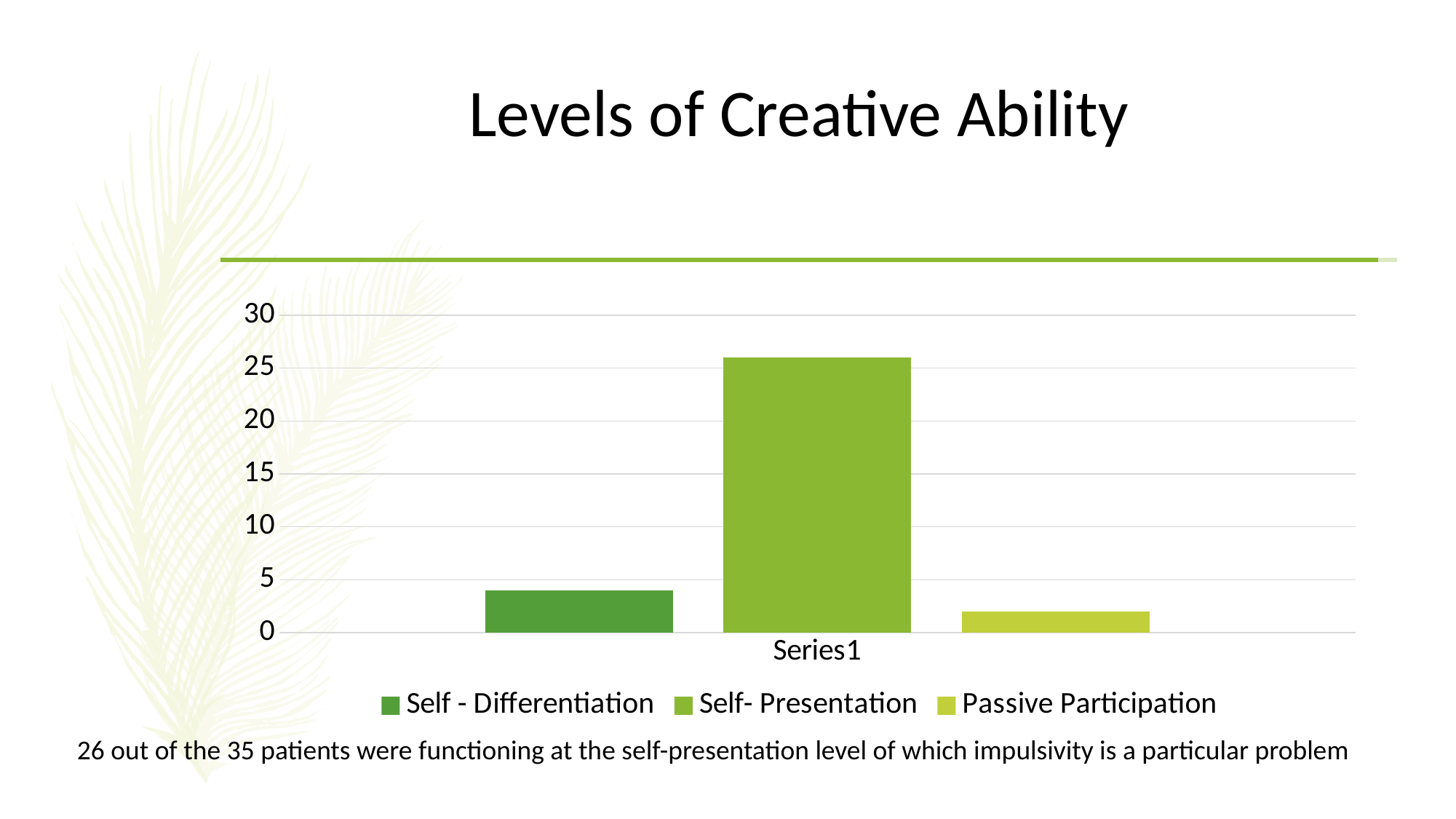
What label appears on the x axis beneath the bars? Series1 What kind of chart is shown on the slide? bar chart Is the value for Self - Differentiation greater or less than 5? less What is the title of the chart? Levels of Creative Ability Which is larger, the bar for Self - Differentiation or the bar for Passive Participation? Self - Differentiation Is the value for Passive Participation greater or less than 5? less Which series has the highest bar? Self- Presentation Which series has the lowest bar? Passive Participation According to the slide, how many patients were functioning at the self-presentation level? 26 Is the value for Self- Presentation greater or less than 20? greater How many bars are plotted in the chart? 3 How many series does the legend list? 3